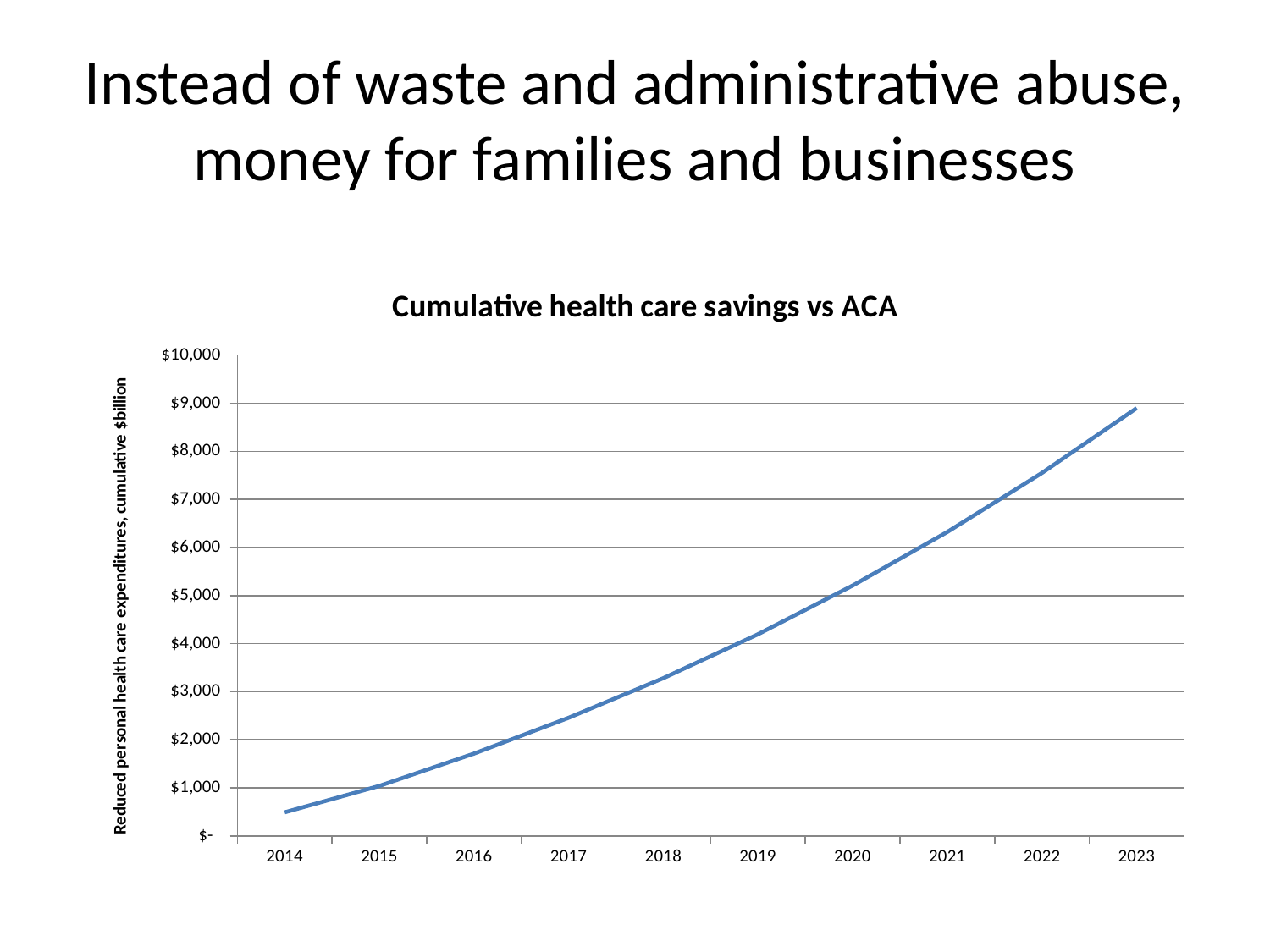
What kind of chart is shown on the slide? line chart What is the label on the vertical axis of the chart? Reduced personal health care expenditures, cumulative $billion Which year has the highest cumulative savings value? 2023 Is the value for 2018 greater or less than $3,000? greater Is the value for 2014 greater or less than $1,000? less Which year has the larger cumulative savings value, 2017 or 2021? 2021 Do the cumulative savings rise or fall from 2014 to 2023? rise How many years are plotted along the x axis of the chart? 10 Is the value for 2023 greater or less than $8,000? greater Which year has the lowest cumulative savings value? 2014 What is the title of the chart? Cumulative health care savings vs ACA